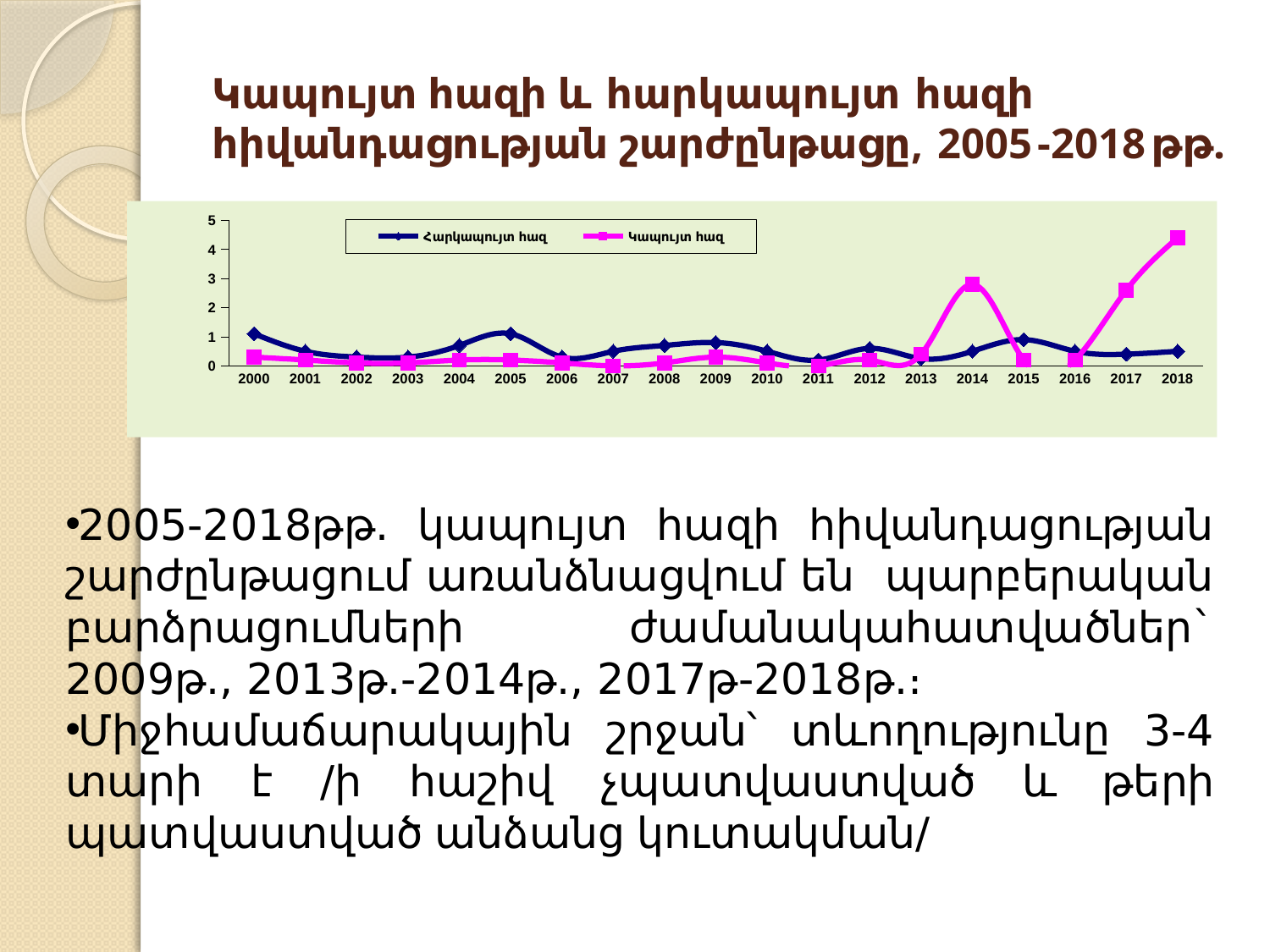
Is the value of Կապույտ հազ in 2018 greater or less than 4? greater What kind of chart is shown on the slide? Line chart Does the Կապույտ հազ series rise or fall from 2016 to 2018? rise Is the value of Կապույտ հազ in 2014 greater or less than 2? greater In 2005, which series has the larger value, Հարկապույտ հազ or Կապույտ հազ? Հարկապույտ հազ What colour is the line for the Կապույտ հազ series? Magenta (pink) How many years are plotted along the x axis of the chart? 19 How many series does the chart legend list? 2 In which year does the Կապույտ հազ series reach its highest value? 2018 In 2018, which series has the larger value, Հարկապույտ հազ or Կապույտ հազ? Կապույտ հազ Is the value of Կապույտ հազ in 2011 greater or less than 1? less